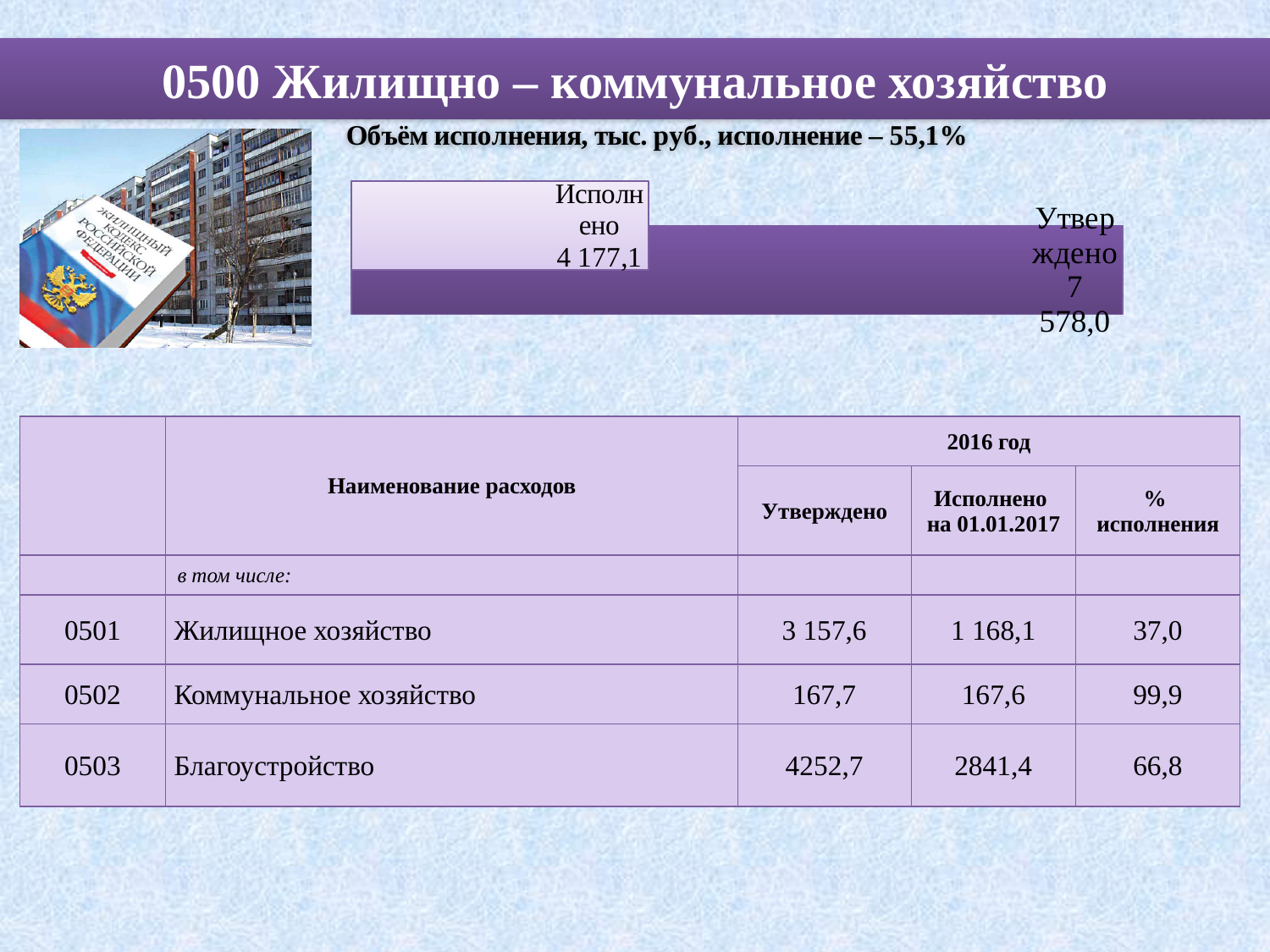
What is the value of the bar labelled Исполнено? 4 177,1 Which bar in the chart has the largest value? Утверждено What is the value of the bar labelled Утверждено? 7 578,0 What execution percentage is stated in the chart title? 55,1% What is the difference between the Утверждено value and the Исполнено value in the chart? 3 400,9 What is the title of the chart? Объём исполнения, тыс. руб., исполнение – 55,1% What kind of chart is shown on the slide? bar chart How many bars are plotted in the chart? 2 Which bar has the higher value, Исполнено or Утверждено? Утверждено Which bar in the chart has the smallest value? Исполнено